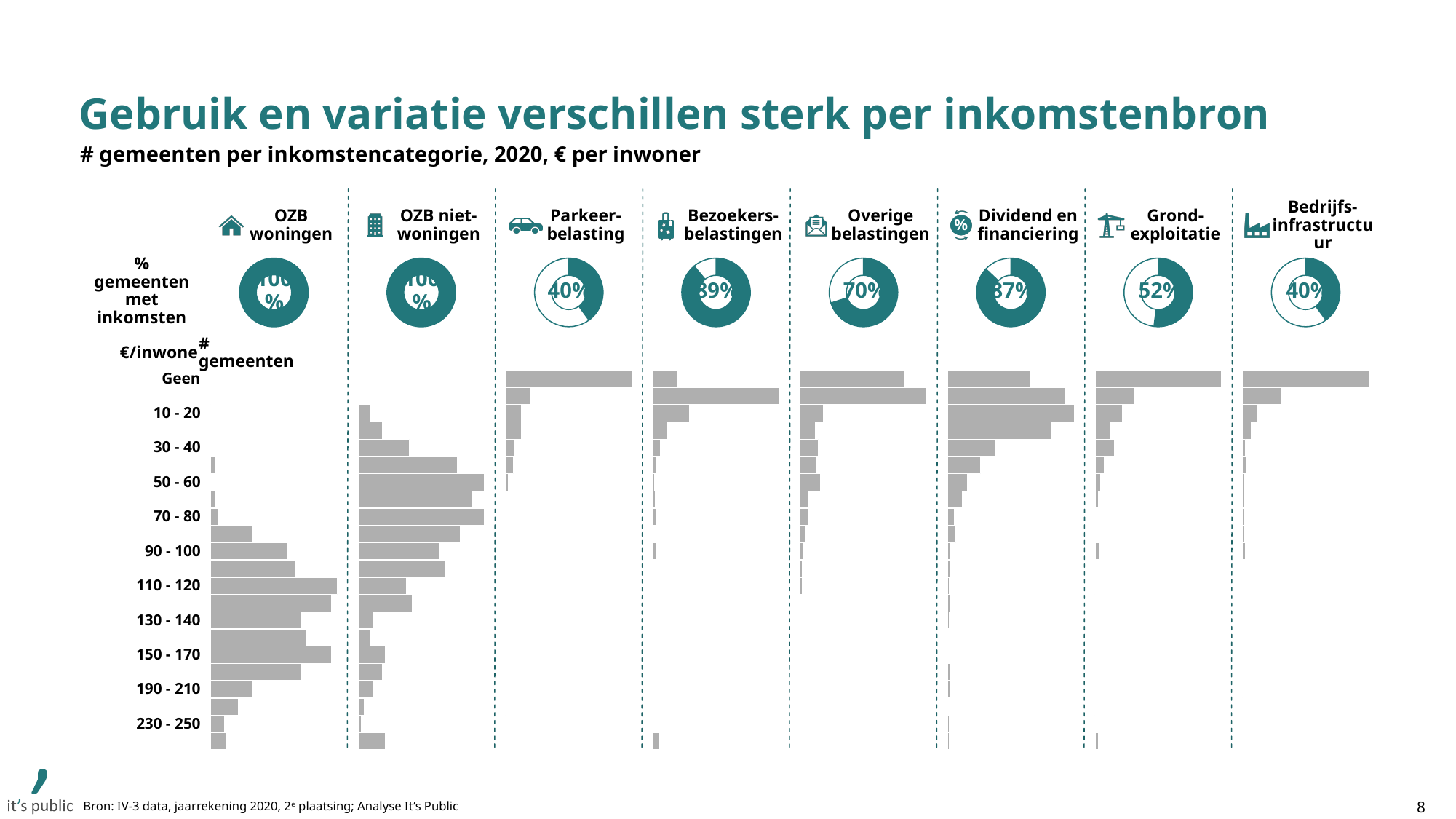
What percentage of municipalities have income from Overige belastingen, according to the donut chart? 70% What kind of chart is used to show the number of municipalities per income category (€/inwoner) for each income source? Bar chart What is the difference in percentage points between the donut values for Bezoekersbelastingen and Grondexploitatie? 37 What percentage of municipalities have income from Bezoekersbelastingen, according to the donut chart? 89% In the Parkeerbelasting bar chart, which income category has the longest bar? Geen Among the donut charts, which income sources show the lowest share of municipalities with income? Parkeerbelasting and Bedrijfsinfrastructuur What percentage of municipalities have income from Grondexploitatie, according to the donut chart? 52% How many income sources (columns) are shown on the slide? 8 What percentage of municipalities have income from Parkeerbelasting, according to the donut chart? 40% Which donut value is larger: Overige belastingen or Dividend en financiering? Dividend en financiering What percentage of municipalities have income from Dividend en financiering, according to the donut chart? 87% Which income sources have a donut chart showing 100% of municipalities with income? OZB woningen and OZB niet-woningen